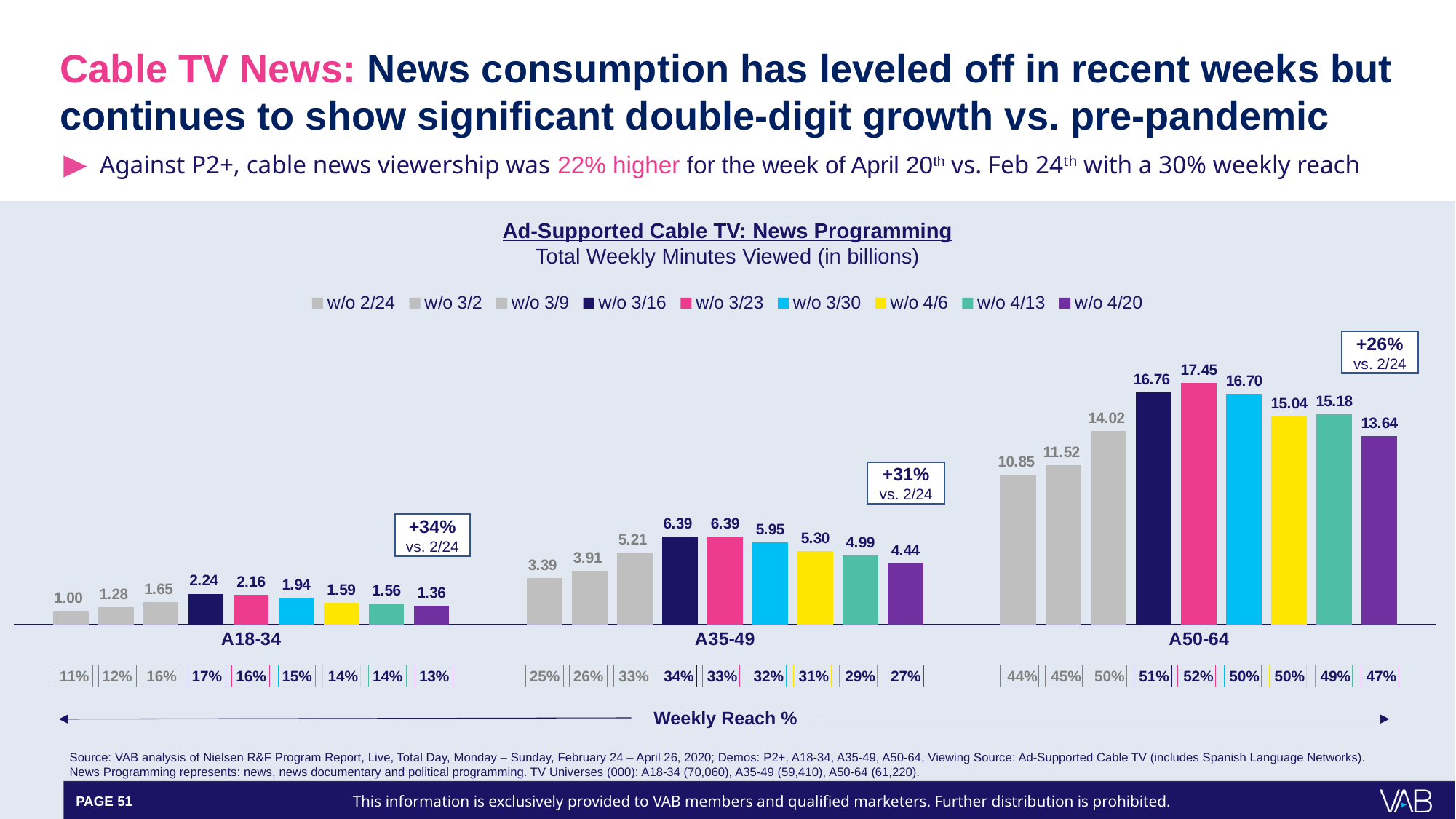
In the A18-34 group, do the values rise or fall from w/o 3/16 to w/o 4/20? Fall In the A35-49 group, which is larger: the value for w/o 3/30 or w/o 4/6? w/o 3/30 Which week has the highest value in the A50-64 group? w/o 3/23 What is the value for w/o 4/20 in the A50-64 group? 13.64 What percentage change vs. 2/24 is shown in the callout above the A35-49 group? +31% What is the value for w/o 4/13 in the A35-49 group? 4.99 How many age groups are shown on the x axis? 3 What is the difference between the w/o 3/23 and w/o 2/24 values in the A50-64 group? 6.60 Which week has the lowest value in the A35-49 group? w/o 2/24 How many series does the legend list? 9 What kind of chart is shown on the slide? Bar chart What is the value for w/o 3/16 in the A18-34 group? 2.24